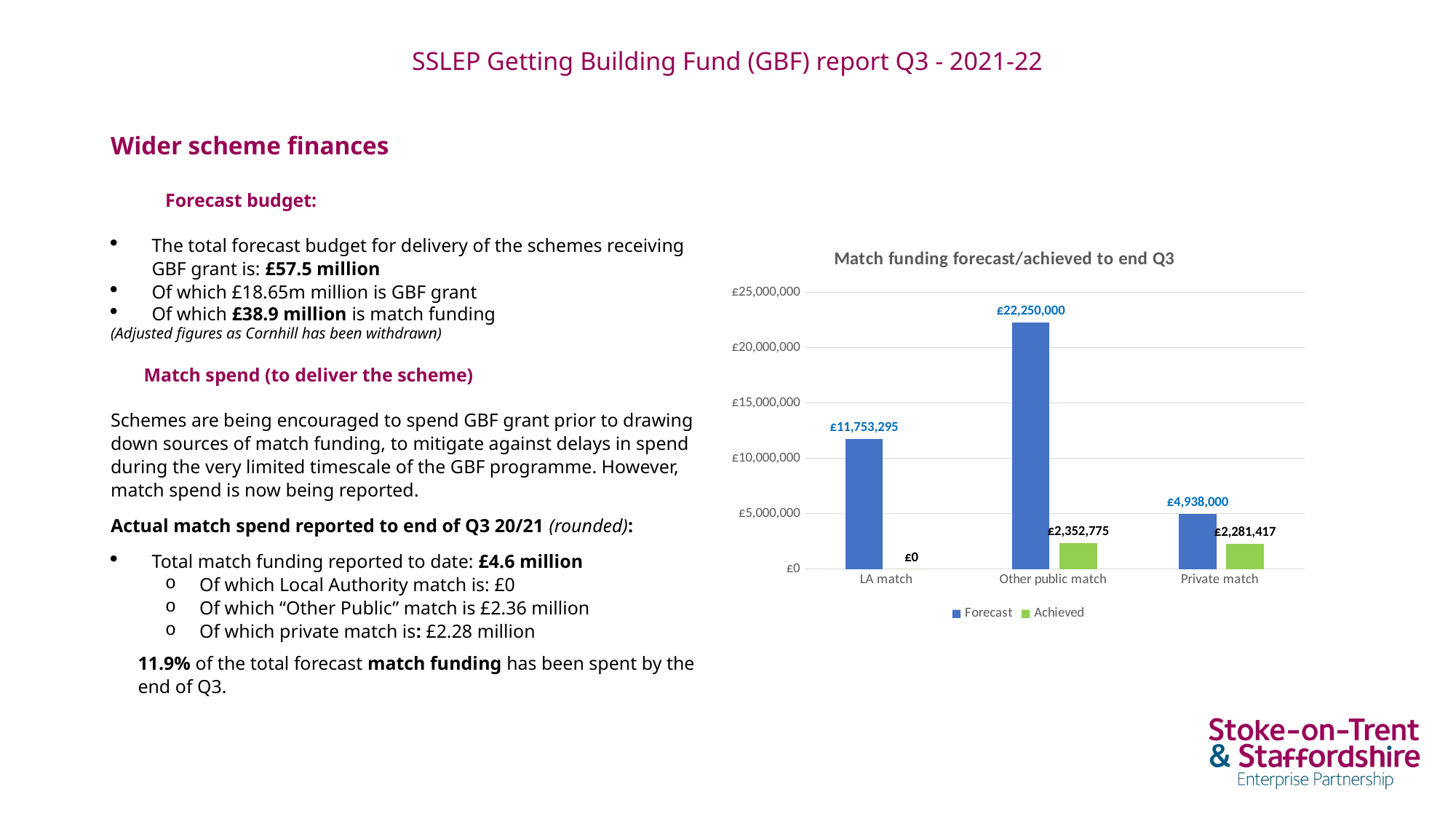
What type of chart is shown on the slide? Bar chart What is the Forecast value for Other public match? £22,250,000 What is the Achieved value for Private match? £2,281,417 What is the difference between the Forecast and Achieved values for Private match? £2,656,583 What is the Achieved value for LA match? £0 Which is larger, the Forecast value for LA match or the Forecast value for Private match? LA match Which category has the lowest Achieved value? LA match Which category has the highest Forecast value? Other public match What is the difference between the Forecast values for Other public match and LA match? £10,496,705 How many categories are shown on the x axis of the chart? 3 What is the Forecast value for LA match? £11,753,295 How many series does the chart legend list? 2